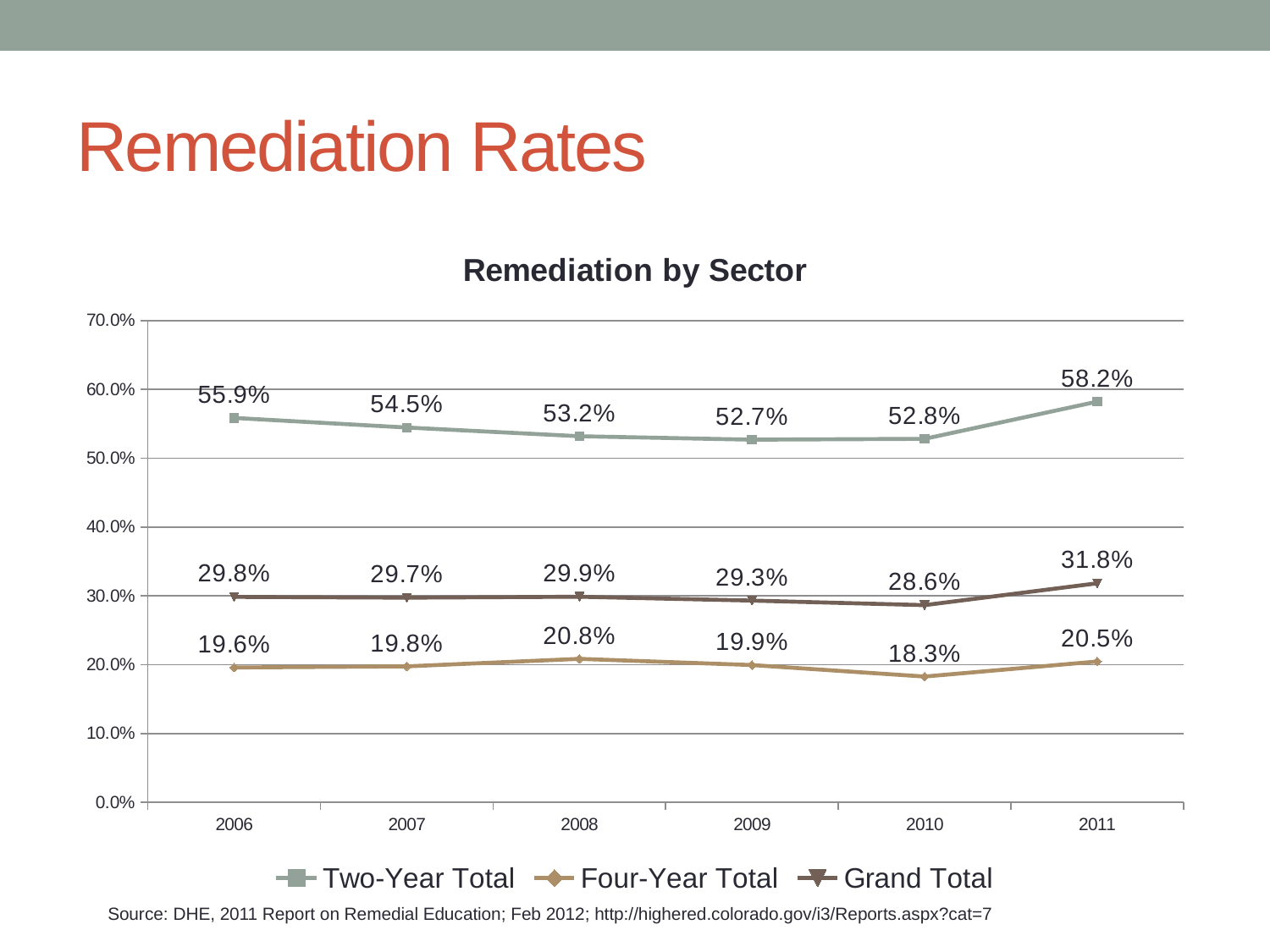
How many years are shown on the x axis? 6 How many series does the legend list? 3 What is the Four-Year Total remediation rate in 2010? 18.3% What is the title of the chart? Remediation by Sector What is the Grand Total remediation rate in 2008? 29.9% What kind of chart is shown on the slide? Line chart In which year is the Four-Year Total remediation rate lowest? 2010 Does the Two-Year Total remediation rate rise or fall from 2006 to 2010? Fall What is the difference between the Two-Year Total and Four-Year Total remediation rates in 2006? 36.3% Which is larger in 2009: the Grand Total rate or the Four-Year Total rate? Grand Total What is the Two-Year Total remediation rate in 2011? 58.2% In which year is the Two-Year Total remediation rate highest? 2011